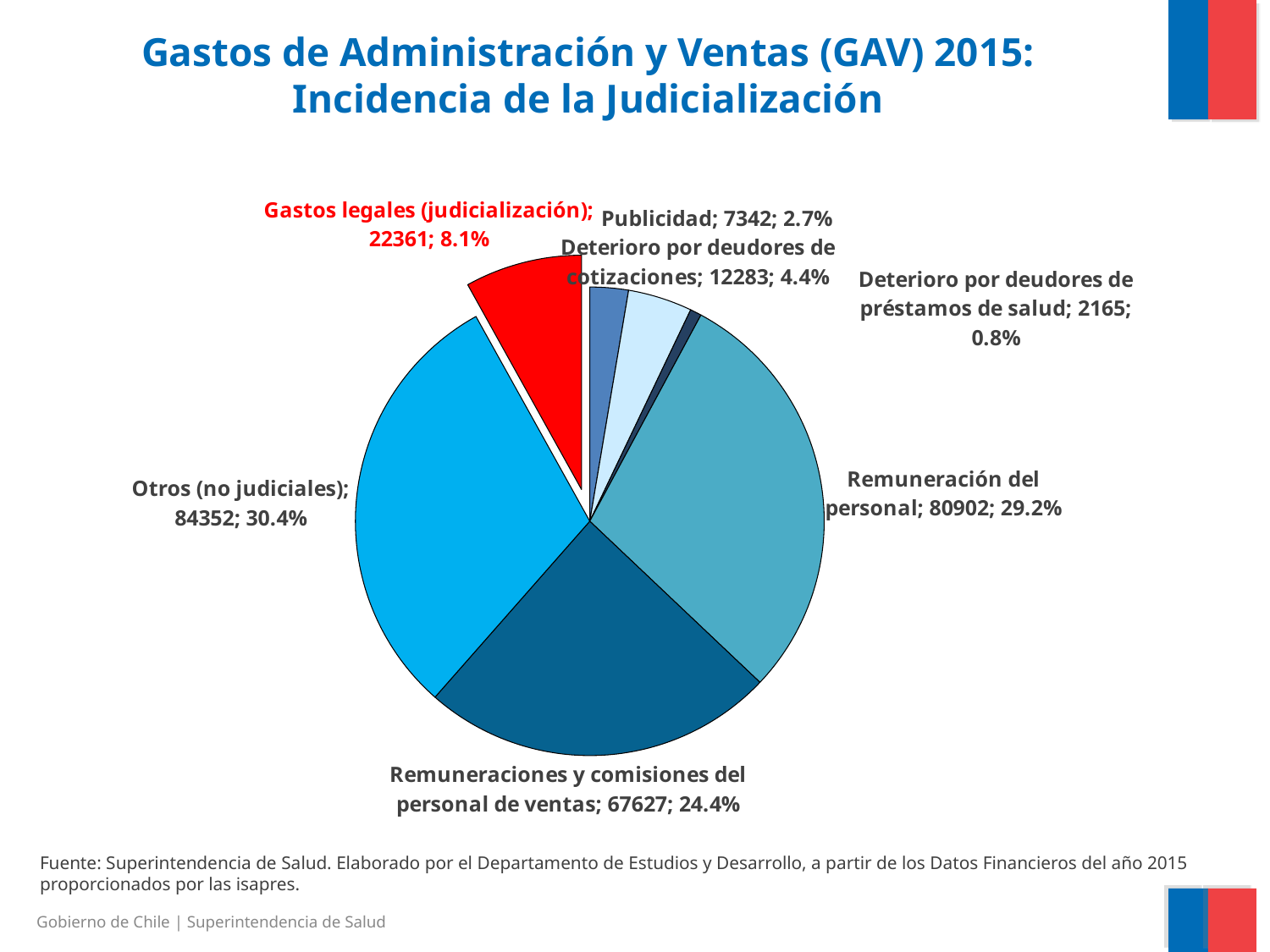
What is the title of the chart on the slide? Gastos de Administración y Ventas (GAV) 2015: Incidencia de la Judicialización What share of the pie does Gastos legales (judicialización) represent? 8.1% What is the value shown for Remuneraciones y comisiones del personal de ventas? 67627 What is the value shown for Gastos legales (judicialización)? 22361 Which category has the largest slice of the pie? Otros (no judiciales) What is the value shown for Remuneración del personal? 80902 What is the difference between the values for Otros (no judiciales) and Remuneración del personal? 3450 Which category has the smallest slice of the pie? Deterioro por deudores de préstamos de salud How many slices does the pie chart have? 7 What kind of chart is shown on the slide? Pie chart Which is larger, the value for Publicidad or the value for Deterioro por deudores de cotizaciones? Deterioro por deudores de cotizaciones What share of the pie does Otros (no judiciales) represent? 30.4%